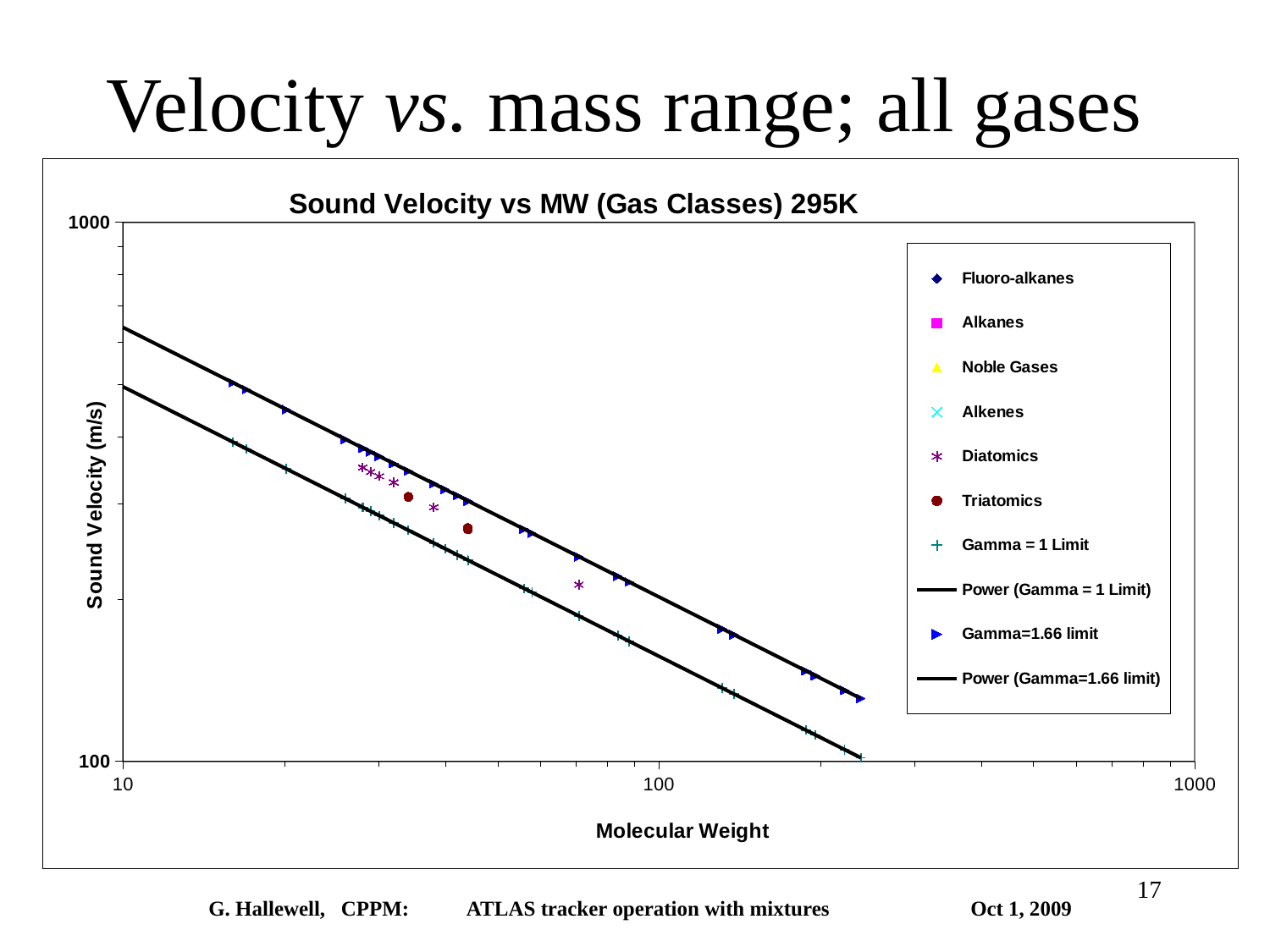
As molecular weight increases along the x axis, does sound velocity rise or fall? Fall What is the title of the chart? Sound Velocity vs MW (Gas Classes) 295K Is the Gamma = 1 Limit value at a molecular weight of 100 greater or less than 100? greater What kind of chart is shown on the slide? Scatter chart Which line lies higher on the chart, the Gamma=1.66 limit or the Gamma = 1 Limit? Gamma=1.66 limit Is the Gamma=1.66 limit value at a molecular weight of 10 greater or less than 1000? less How many series does the legend list? 10 What is the label of the y axis? Sound Velocity (m/s)